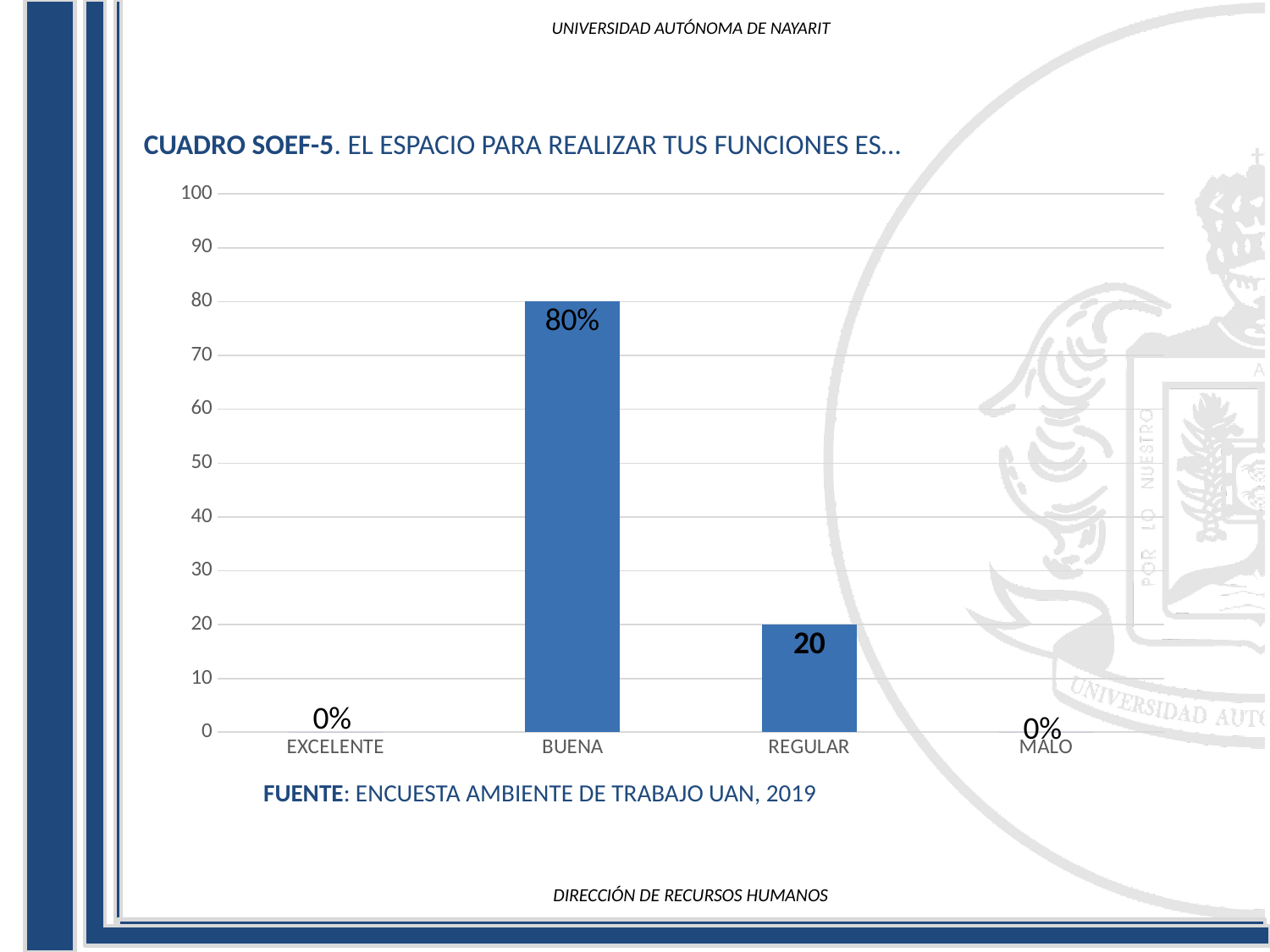
What is the value for BUENA? 80% What is the value for MALO? 0% What kind of chart is shown on the slide? bar chart What is the value for REGULAR? 20 What is the difference between the values for BUENA and REGULAR? 60 Is the value for BUENA greater or less than 50? greater Which category has the highest value? BUENA What is the value for EXCELENTE? 0% What is the source cited below the chart? ENCUESTA AMBIENTE DE TRABAJO UAN, 2019 Is the value for REGULAR greater or less than 30? less How many categories are shown on the x axis? 4 Which of BUENA or REGULAR has the larger value? BUENA